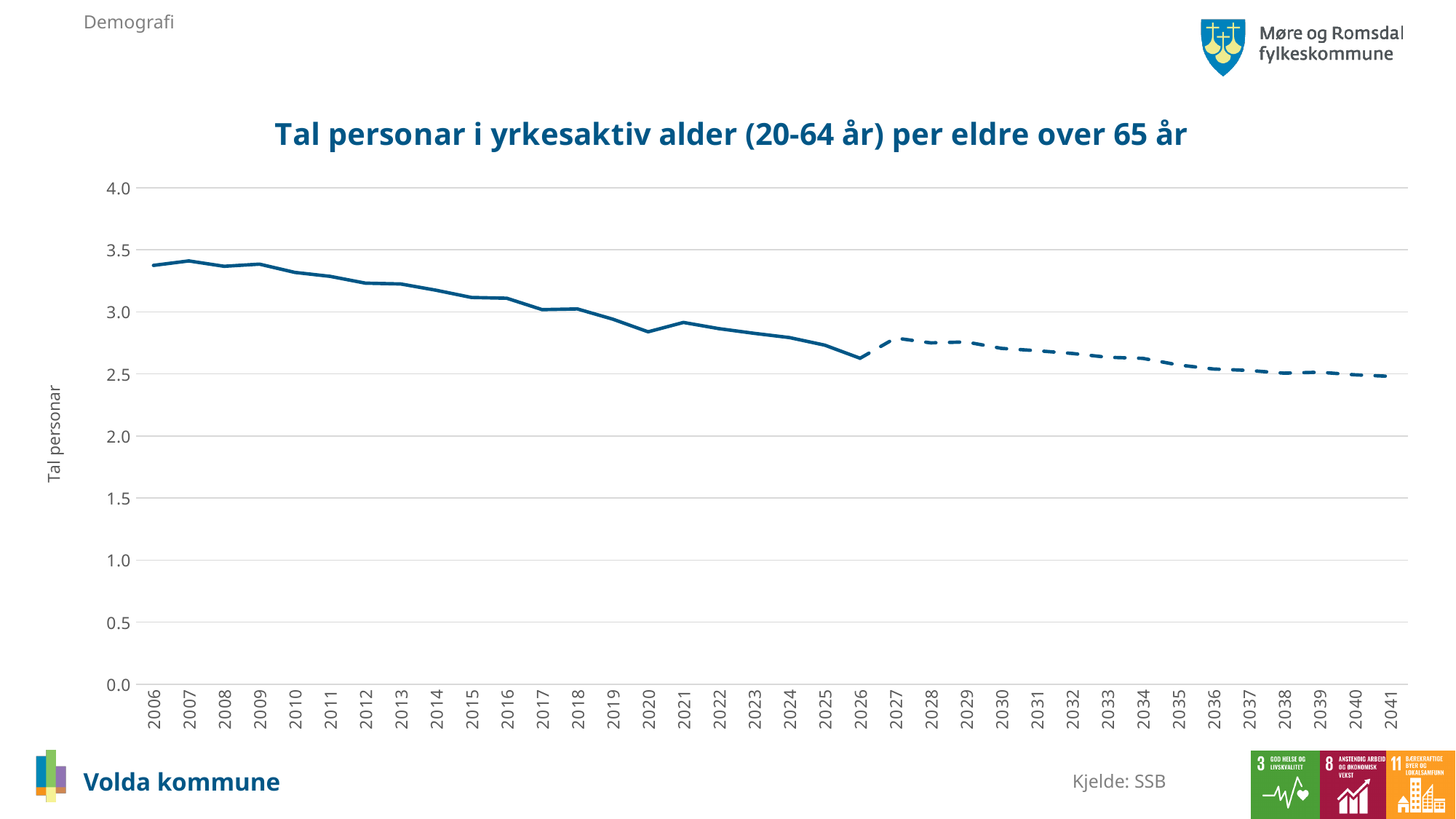
Is the value for 2006 greater or less than 3.0? greater Is the value for 2020 greater or less than 3.0? less Which year has the larger value, 2007 or 2026? 2007 What is the title of the chart? Tal personar i yrkesaktiv alder (20-64 år) per eldre over 65 år What is the label on the vertical axis of the chart? Tal personar What kind of chart is shown on the slide? line chart Which year has the larger value, 2006 or 2041? 2006 Is the value for 2013 greater or less than 3.0? greater Do the values generally rise or fall from 2006 to 2041? fall How many years are shown along the x axis of the chart? 36